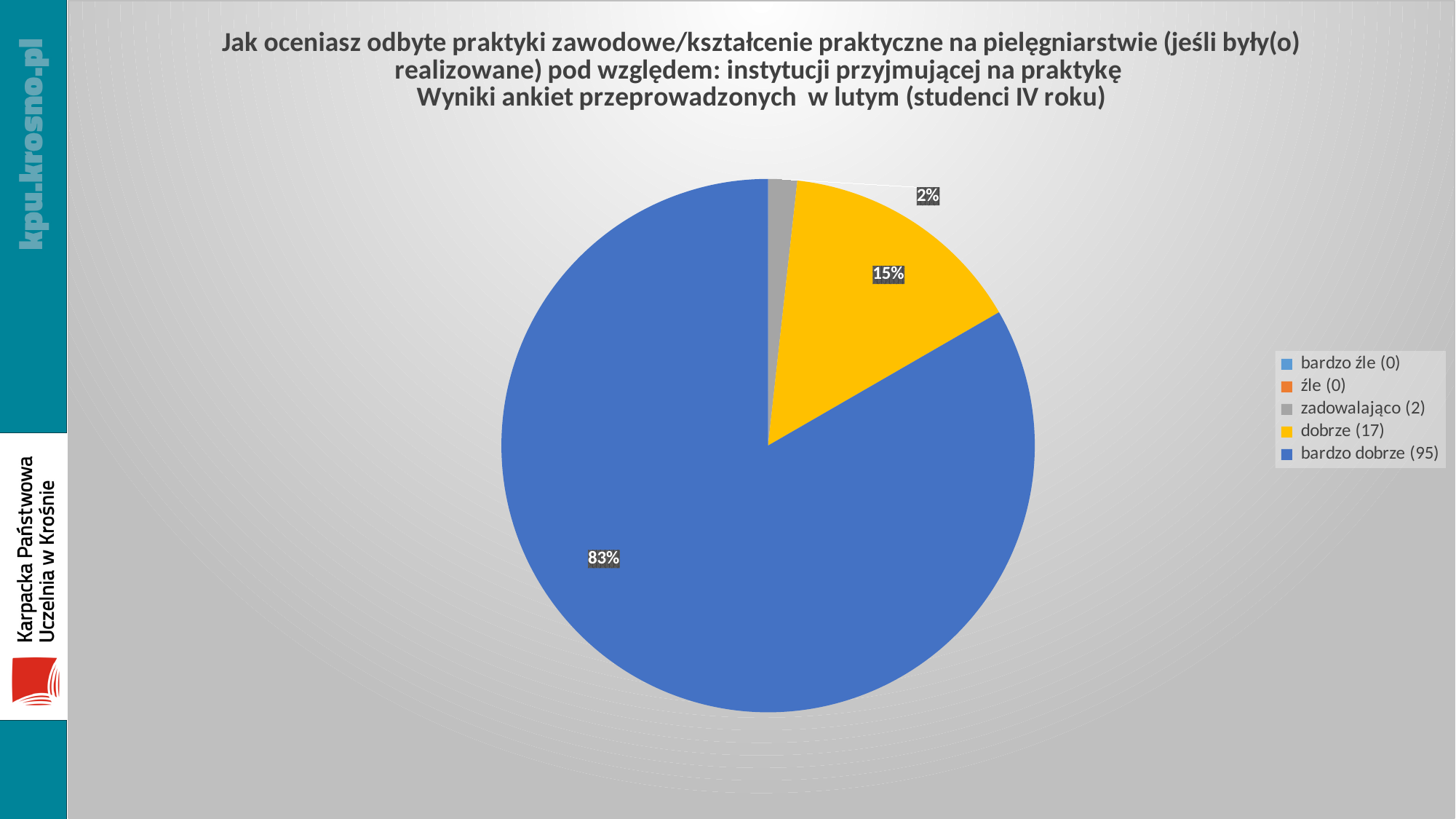
How many entries does the legend list? 5 Which group of students does the chart title say the survey was conducted among? studenci IV roku What colour is the 'dobrze (17)' slice? yellow What percentage share does the 'bardzo dobrze (95)' slice have? 83% Which is larger, the 'dobrze (17)' slice or the 'zadowalająco (2)' slice? dobrze (17) What kind of chart is shown on the slide? pie chart Which category has the largest slice of the pie? bardzo dobrze (95) What percentage share does the 'dobrze (17)' slice have? 15% How many responses does the legend show for 'źle'? 0 How many responses does the legend show for 'bardzo źle'? 0 What is the difference in percentage points between the 'bardzo dobrze' slice and the 'dobrze' slice? 68 What percentage share does the 'zadowalająco (2)' slice have? 2%